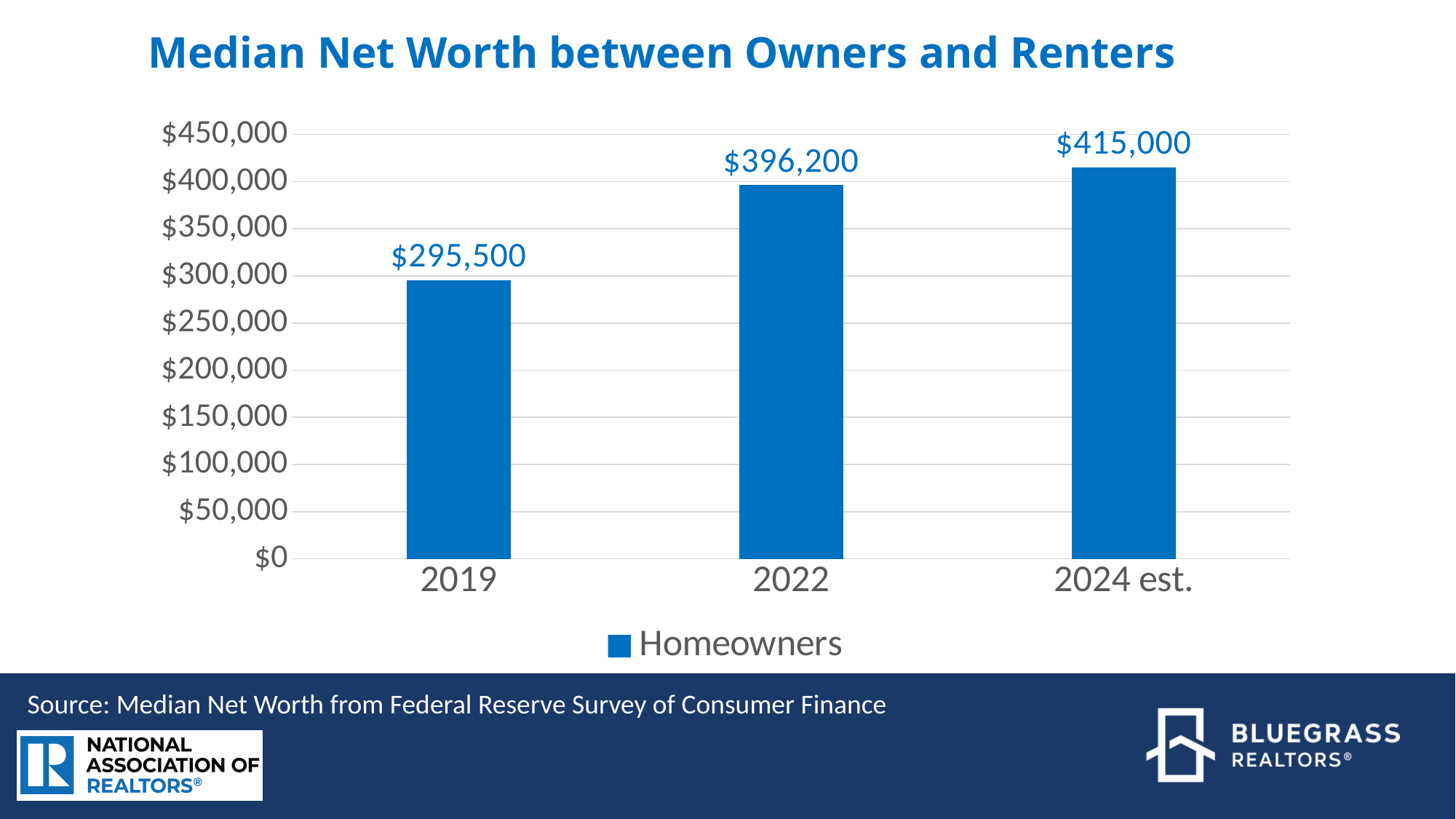
Which is larger, the median net worth in 2019 or in 2022? 2022 Is the median net worth for 2019 greater or less than $300,000? less How many years are shown on the x axis? 3 Which year has the highest median net worth for homeowners? 2024 est. What kind of chart is shown on the slide? bar chart What is the difference in median net worth between 2024 est. and 2022? $18,800 What is the difference in median net worth between 2022 and 2019? $100,700 What is the median net worth of homeowners in 2019? $295,500 Which year has the lowest median net worth for homeowners? 2019 What is the estimated median net worth of homeowners in 2024? $415,000 Do the values rise or fall from 2019 to 2024 est.? rise What is the median net worth of homeowners in 2022? $396,200